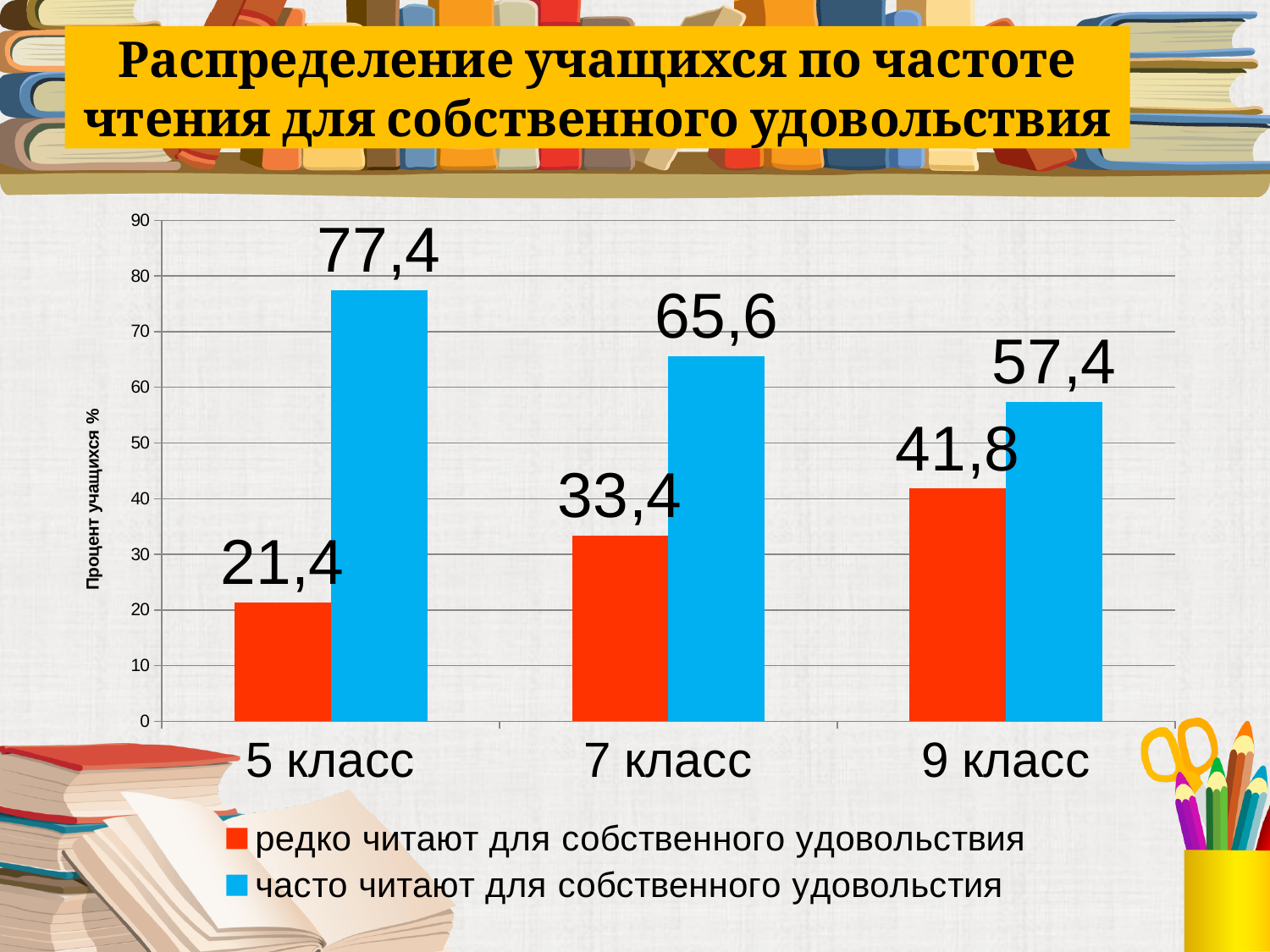
Which class has the lowest value in the series 'редко читают для собственного удовольствия'? 5 класс How many classes (categories) are shown on the x axis? 3 Do the values in the series 'редко читают для собственного удовольствия' rise or fall from 5 класс to 9 класс? rise How many series does the legend list? 2 What kind of chart is shown on the slide? bar chart What is the difference between the 'часто читают' values for 5 класс and 9 класс? 20,0 Which class has the highest value in the series 'часто читают для собственного удовольствия'? 5 класс What is the value for 5 класс in the series 'редко читают для собственного удовольствия'? 21,4 What is the value for 7 класс in the series 'часто читают для собственного удовольствия'? 65,6 What is the difference between the 'часто читают' and 'редко читают' values for 9 класс? 15,6 Which is larger for 7 класс: the 'редко читают' value or the 'часто читают' value? часто читают для собственного удовольствия What is the value for 9 класс in the series 'редко читают для собственного удовольствия'? 41,8